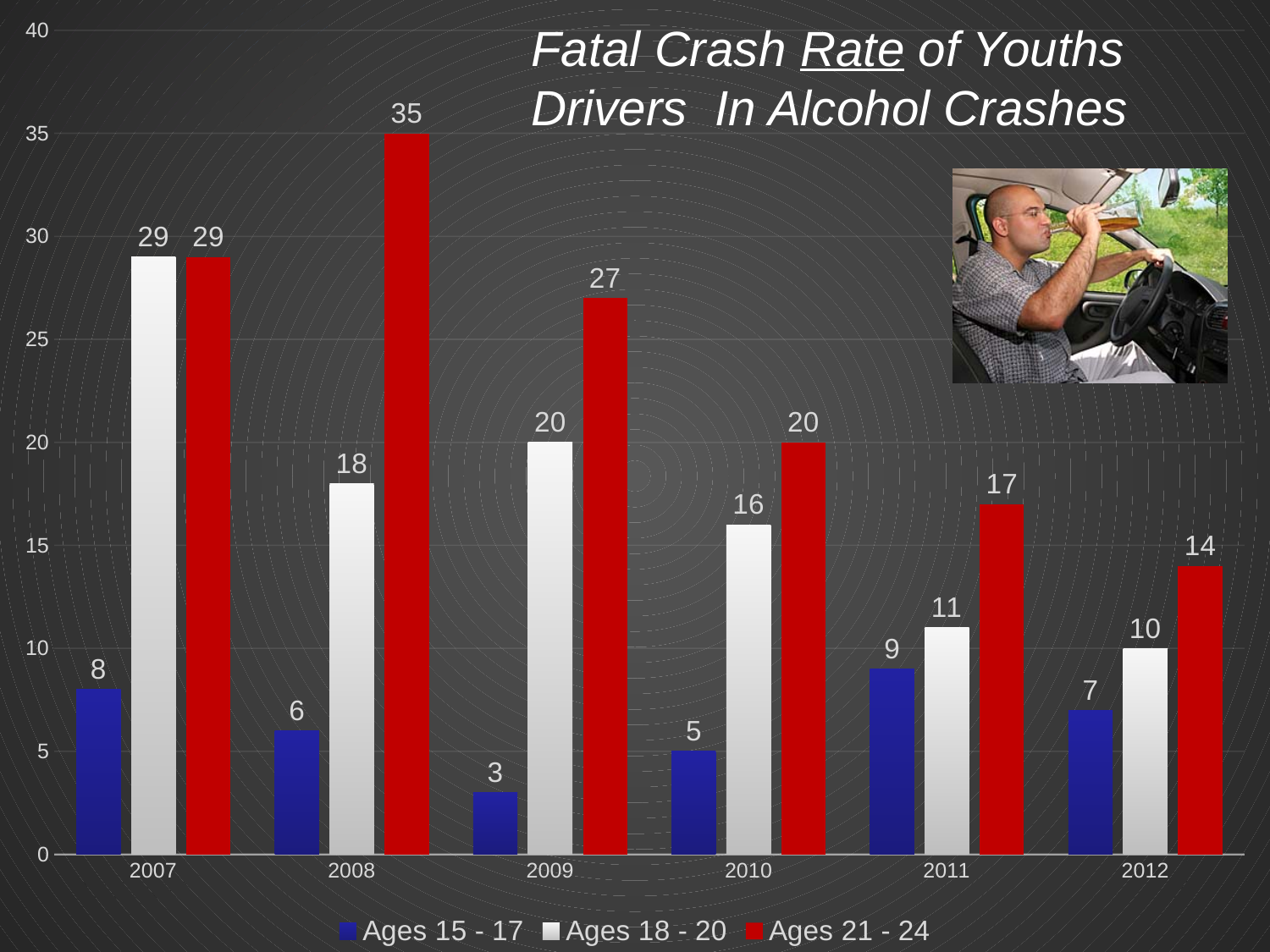
In which year is the Ages 15 - 17 value lowest? 2009 What kind of chart is shown on the slide? Bar chart What is the value for Ages 15 - 17 in 2009? 3 What is the value for Ages 18 - 20 in 2011? 11 Does the Ages 18 - 20 value rise or fall from 2007 to 2008? Fall Which is larger in 2012: the Ages 18 - 20 value or the Ages 21 - 24 value? Ages 21 - 24 What is the value for Ages 21 - 24 in 2008? 35 What colour are the bars for Ages 21 - 24? Red How many years are shown on the x axis? 6 How many series does the legend list? 3 What is the difference between the Ages 21 - 24 and Ages 15 - 17 values in 2010? 15 In which year is the Ages 21 - 24 value highest? 2008